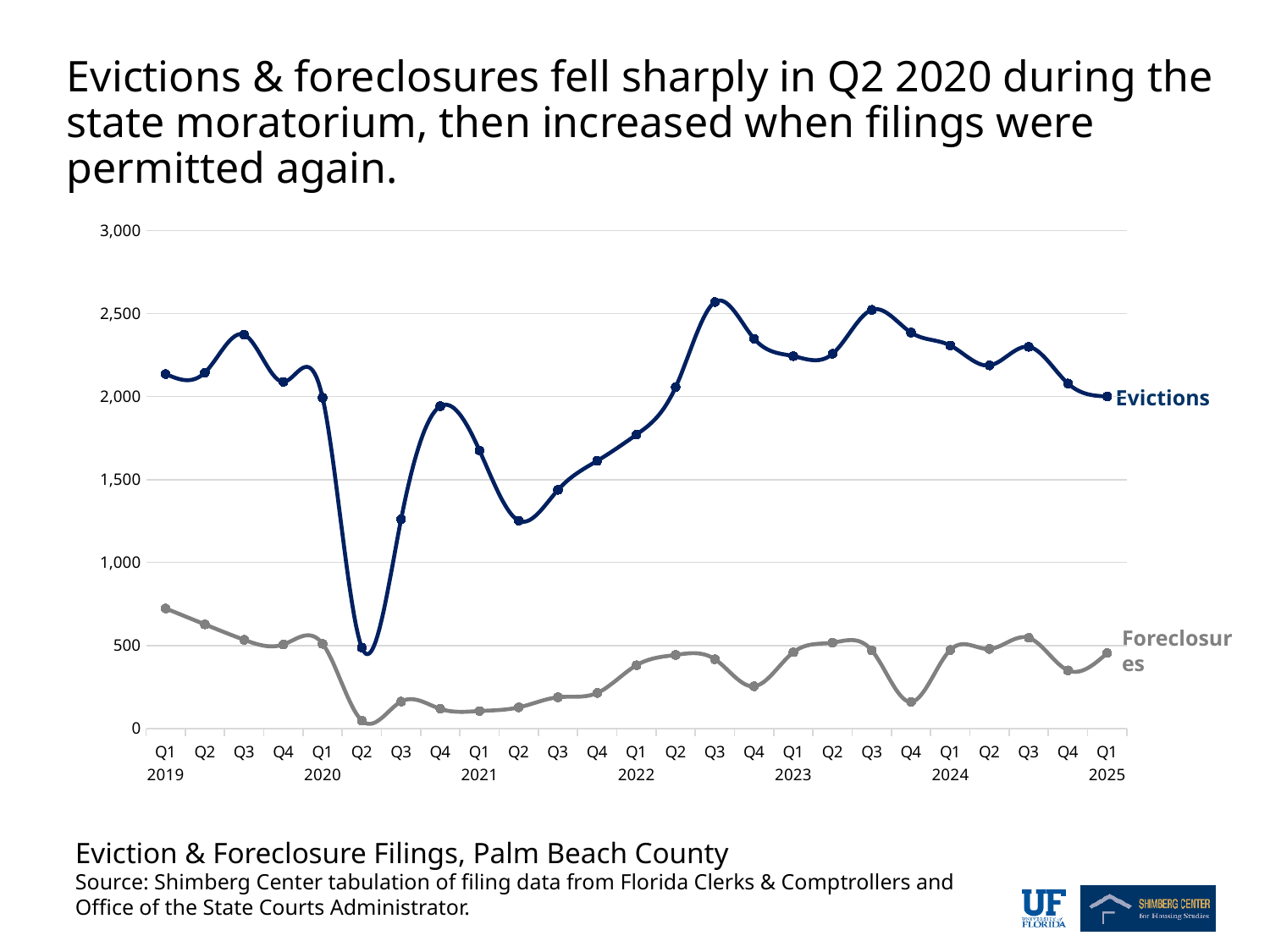
Is the value for Foreclosures in Q1 2019 greater or less than 500? greater In which quarter do Evictions reach their lowest value? Q2 2020 How many series are plotted on the chart? 2 Is the value for Evictions in Q2 2020 greater or less than 1,000? less In which quarter do Foreclosures reach their lowest value? Q2 2020 Which is larger, Evictions in Q4 2020 or Evictions in Q2 2021? Q4 2020 Is the value for Evictions in Q1 2019 greater or less than 2,000? greater What is the title of the chart given below the plot? Eviction & Foreclosure Filings, Palm Beach County What kind of chart is shown on the slide? Line chart How many quarterly data points does each line have, from Q1 2019 to Q1 2025? 25 Do Evictions rise or fall from Q1 2020 to Q2 2020? Fall In which quarter do Foreclosures reach their highest value? Q1 2019